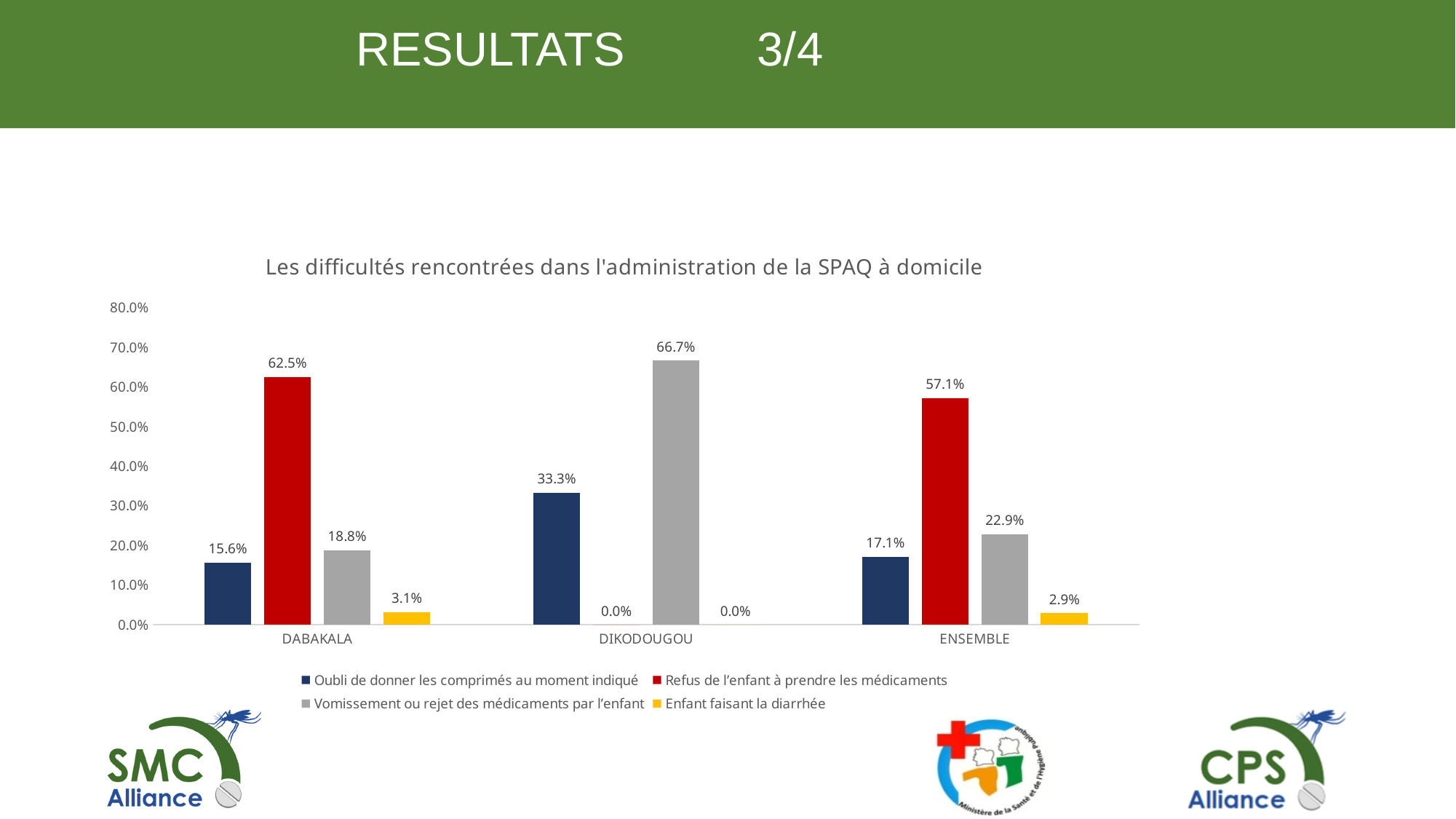
How many categories are shown on the x axis? 3 Which series has the highest value in DIKODOUGOU? Vomissement ou rejet des médicaments par l'enfant What is the value for 'Vomissement ou rejet des médicaments par l'enfant' in DIKODOUGOU? 66.7% What is the difference between 'Refus de l'enfant à prendre les médicaments' in DABAKALA and in ENSEMBLE? 5.4% Which is larger: 'Oubli de donner les comprimés au moment indiqué' in DABAKALA or in DIKODOUGOU? DIKODOUGOU What kind of chart is shown on the slide? Bar chart How many series does the legend list? 4 What is the value for 'Oubli de donner les comprimés au moment indiqué' in ENSEMBLE? 17.1% What is the value for 'Enfant faisant la diarrhée' in DABAKALA? 3.1% What is the title of the chart? Les difficultés rencontrées dans l'administration de la SPAQ à domicile What is the value for 'Refus de l'enfant à prendre les médicaments' in DABAKALA? 62.5% Which series has the lowest value in ENSEMBLE? Enfant faisant la diarrhée